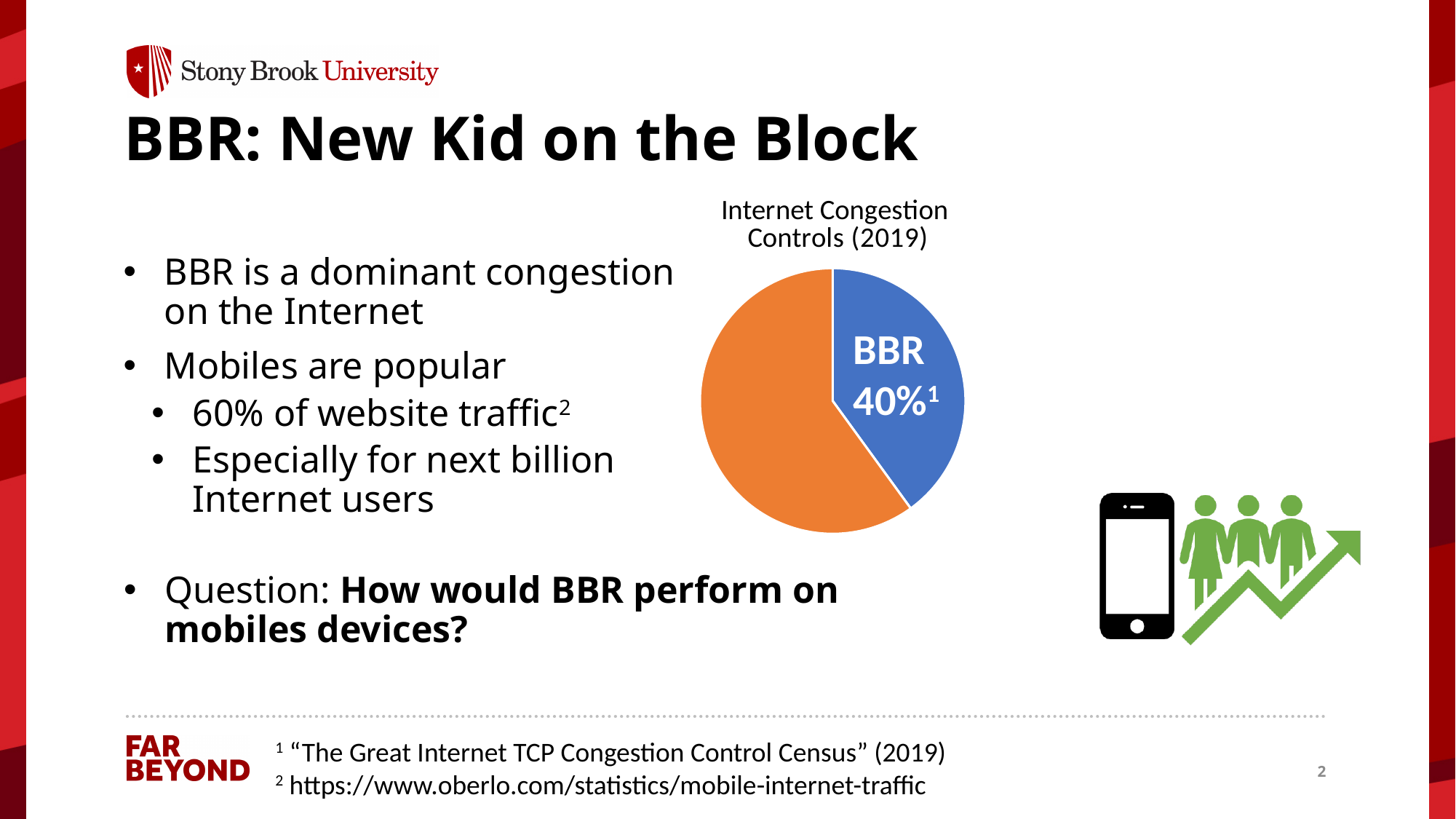
What colour is the BBR slice in the pie chart? blue Is the BBR slice larger or smaller than the orange slice? smaller What share of the pie does BBR account for? 40% How many slices does the pie chart have? 2 Which slice of the pie chart is the smallest? BBR What is the title of the pie chart? Internet Congestion Controls (2019) What share of the pie does the orange slice represent? 60% Which slice of the pie chart is the largest? the orange slice What kind of chart is shown on the slide? pie chart